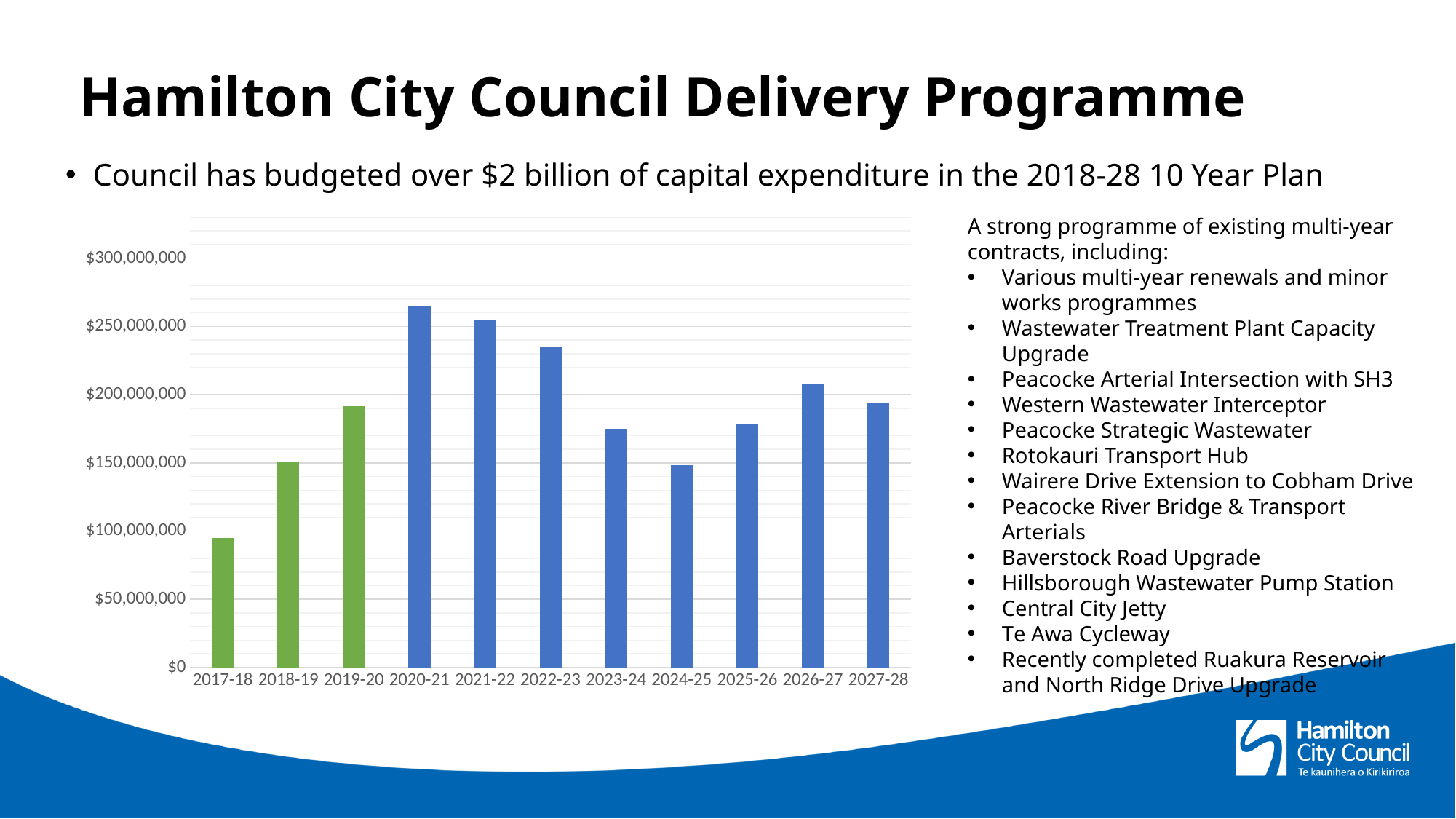
How many financial years are shown on the x axis of the chart? 11 Is the value for 2026-27 greater or less than $200,000,000? greater Is the value for 2020-21 greater or less than $250,000,000? greater Which year has the lowest capital expenditure in the chart? 2017-18 Which year has the highest capital expenditure in the chart? 2020-21 Is the value for 2019-20 greater or less than $200,000,000? less Which is larger, the value for 2021-22 or the value for 2022-23? 2021-22 What kind of chart is shown on the slide? bar chart Which is larger, the value for 2026-27 or the value for 2027-28? 2026-27 Do the values rise or fall from 2020-21 to 2024-25? fall How many bars in the chart are coloured green? 3